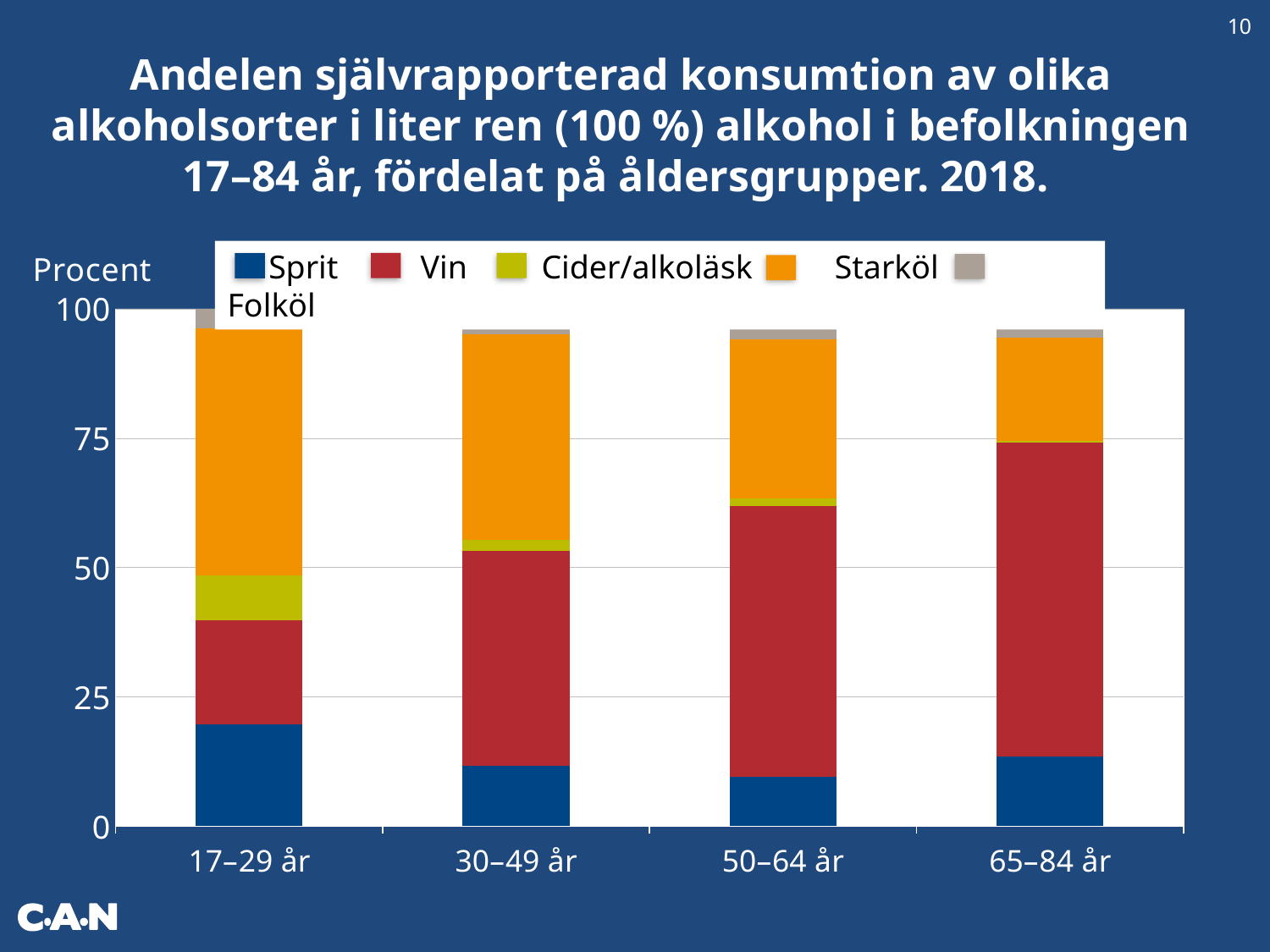
How many series does the legend list? 5 Is the Sprit share for 17–29 år greater or less than 25? less Is the Vin share for 65–84 år greater or less than 50? greater Which age group has the largest Vin share? 65–84 år How many age groups are shown on the x axis? 4 Does the Vin share rise or fall as the age groups get older? rise Which is larger, the Sprit share for 17–29 år or for 50–64 år? 17–29 år What label is shown on the vertical axis? Procent Which age group has the largest Sprit share? 17–29 år Which age group has the smallest Vin share? 17–29 år Which age group has the largest Starköl share? 17–29 år What kind of chart is shown on the slide? Stacked bar chart